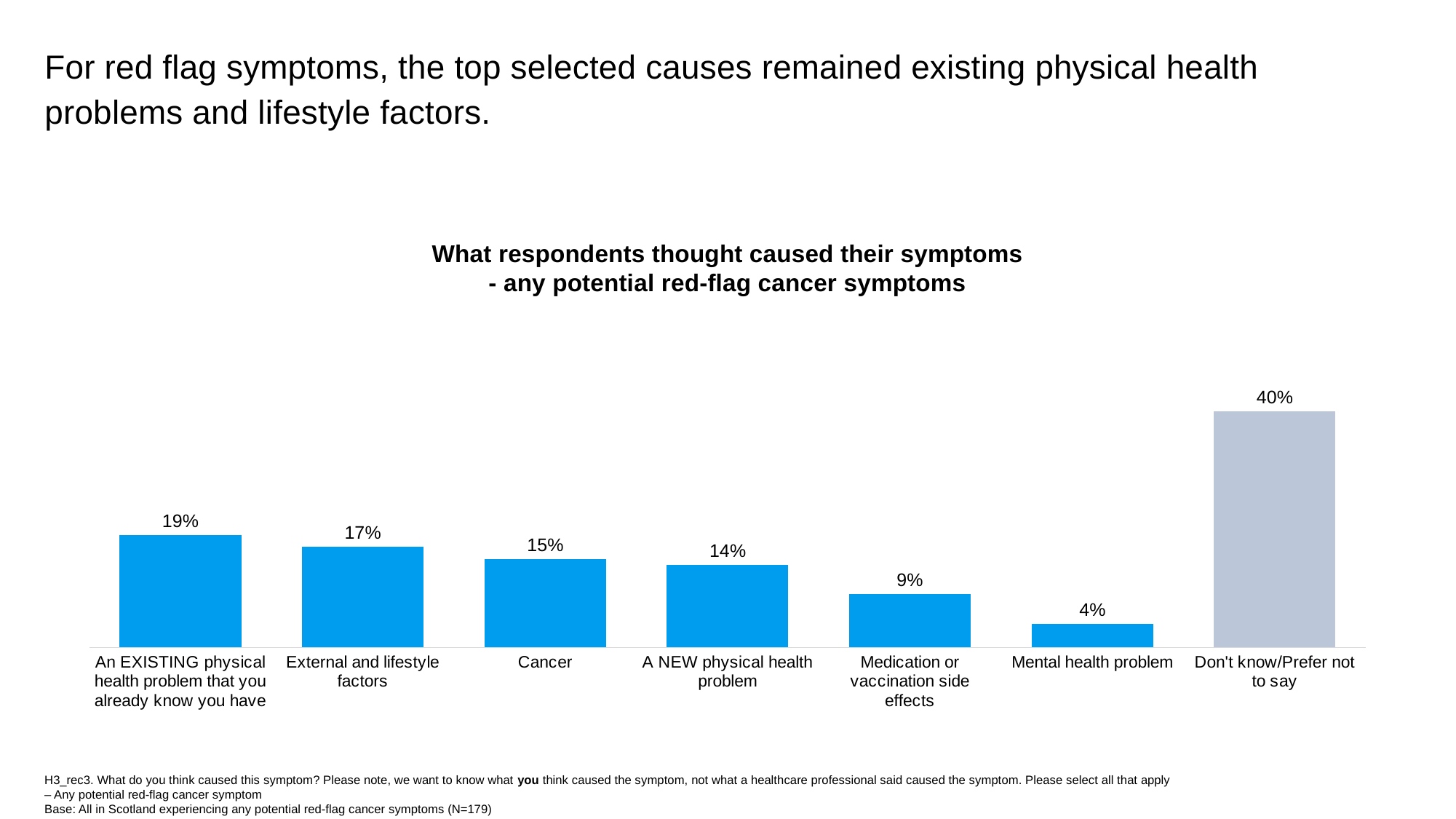
What is the title of the chart? What respondents thought caused their symptoms - any potential red-flag cancer symptoms Which category has the lowest value in the chart? Mental health problem What is the difference between the values for External and lifestyle factors and A NEW physical health problem? 3 percentage points Which category has the highest value in the chart? Don't know/Prefer not to say Which bar is shown in a different colour (grey) from the others? Don't know/Prefer not to say What is the value shown for Cancer? 15% How many categories are shown in the chart? 7 What type of chart is shown on the slide? Bar chart What percentage is shown for Medication or vaccination side effects? 9% What is the value for Don't know/Prefer not to say? 40% Which is larger: the value for Cancer or the value for Medication or vaccination side effects? Cancer What percentage of respondents thought an existing physical health problem that they already know they have caused their symptoms? 19%